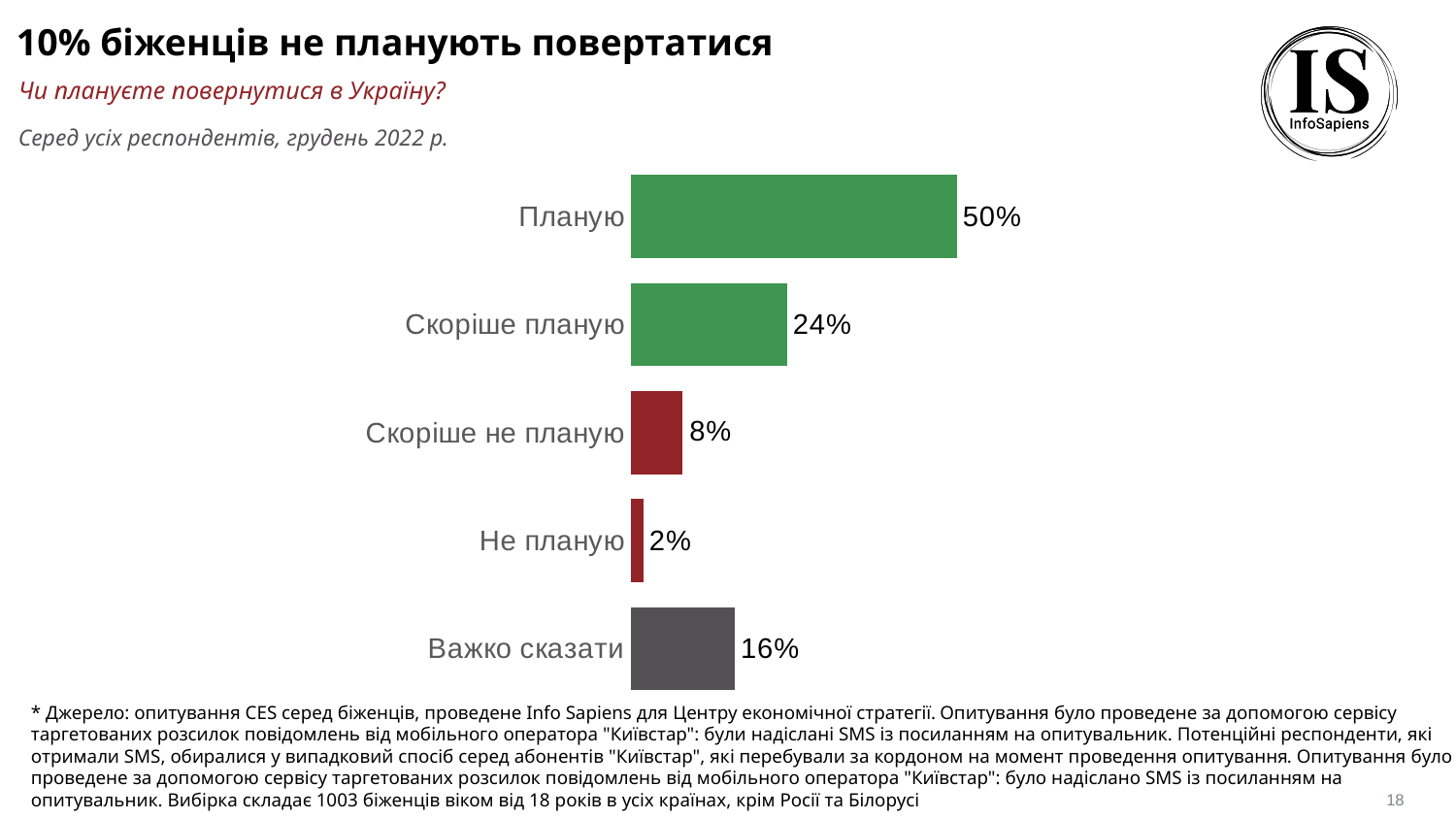
What kind of chart is shown on the slide? Bar chart What is the value for "Скоріше планую"? 24% Which category has the lowest value? Не планую What is the value for "Не планую"? 2% What is the value for "Скоріше не планую"? 8% Which category has the highest value? Планую What colour are the bars for "Скоріше не планую" and "Не планую"? Red What is the value for "Важко сказати"? 16% How many categories are shown in the chart? 5 Which is larger, the value for "Важко сказати" or the value for "Скоріше не планую"? Важко сказати What is the difference between the values for "Планую" and "Скоріше планую"? 26% What is the value for "Планую"? 50%